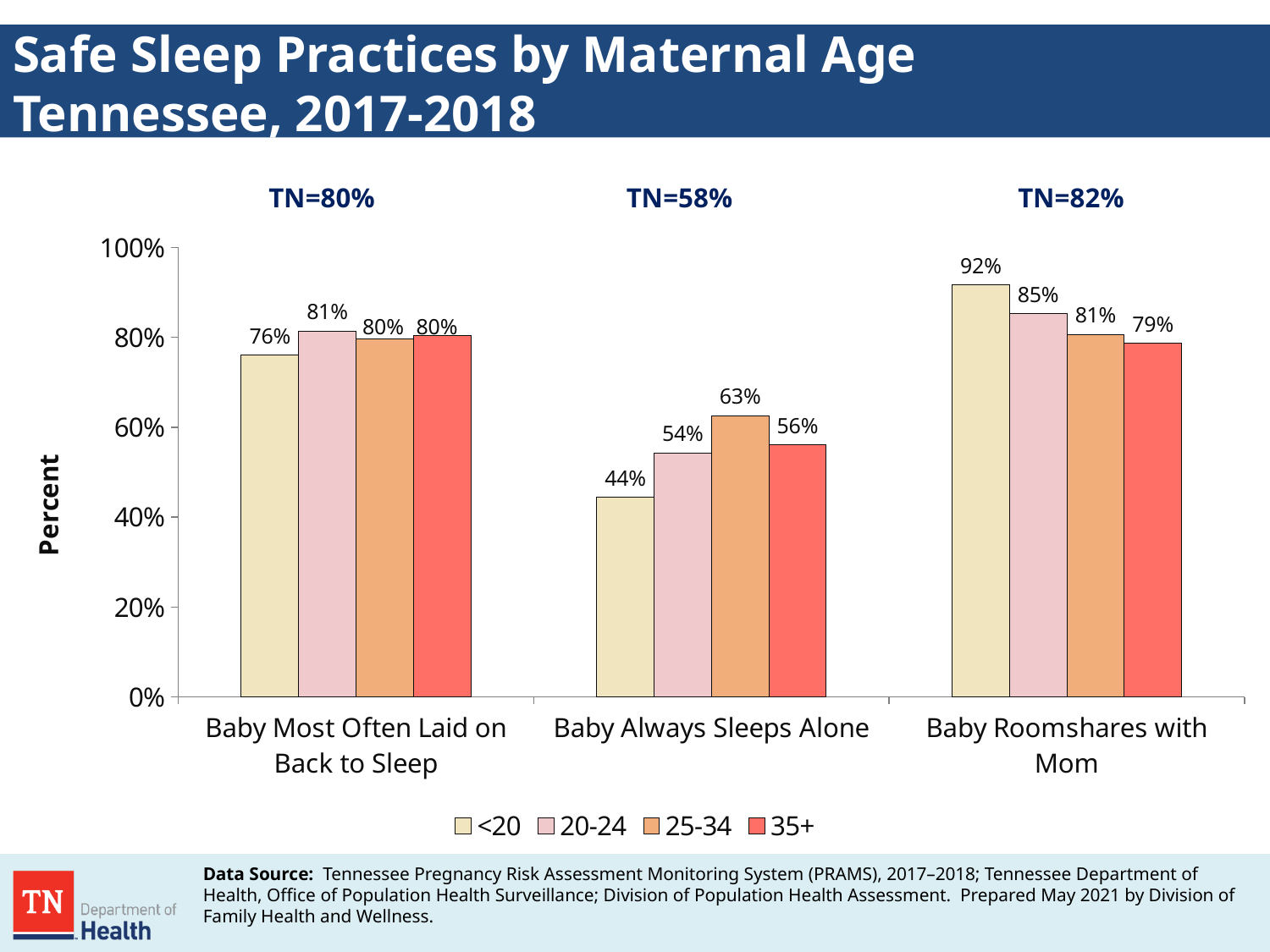
What is the value for the 35+ age group for Baby Roomshares with Mom? 79% Which age group has the lowest value for Baby Always Sleeps Alone? <20 Which is larger for Baby Always Sleeps Alone: the 20-24 value or the 35+ value? 35+ What is the value for the <20 age group for Baby Most Often Laid on Back to Sleep? 76% What is the value for the 25-34 age group for Baby Always Sleeps Alone? 63% What is the difference between the 20-24 and <20 values for Baby Roomshares with Mom? 7% How many age groups does the legend list? 4 Which age group has the highest value for Baby Roomshares with Mom? <20 Is the value for the <20 age group for Baby Always Sleeps Alone greater or less than 60%? less What is the Tennessee overall value (TN=) shown above the Baby Always Sleeps Alone group? 58% What kind of chart is shown on the slide? Bar chart How many safe sleep practice categories are shown on the x axis? 3